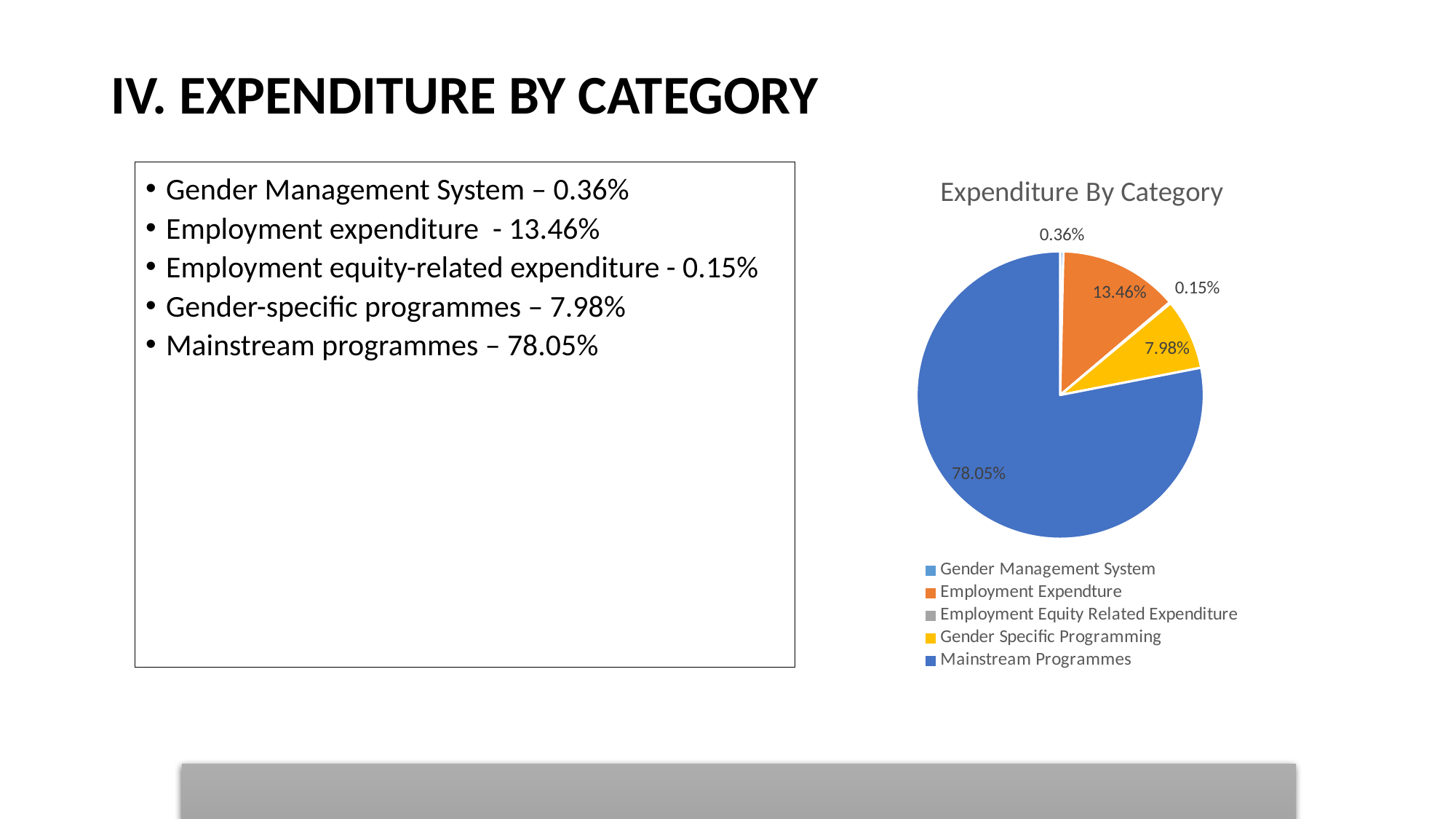
Which is larger, the share for Gender Management System or the share for Employment Equity Related Expenditure? Gender Management System What share of expenditure is Mainstream Programmes? 78.05% What share of expenditure is Gender Specific Programming? 7.98% What is the title of the chart? Expenditure By Category Which category has the largest share of expenditure? Mainstream Programmes What share of expenditure is Employment Expendture? 13.46% What is the difference in percentage points between Employment Expendture and Gender Specific Programming? 5.48 Which category has the smallest share of expenditure? Employment Equity Related Expenditure How many categories does the pie chart show? 5 What type of chart is shown on the slide? pie chart